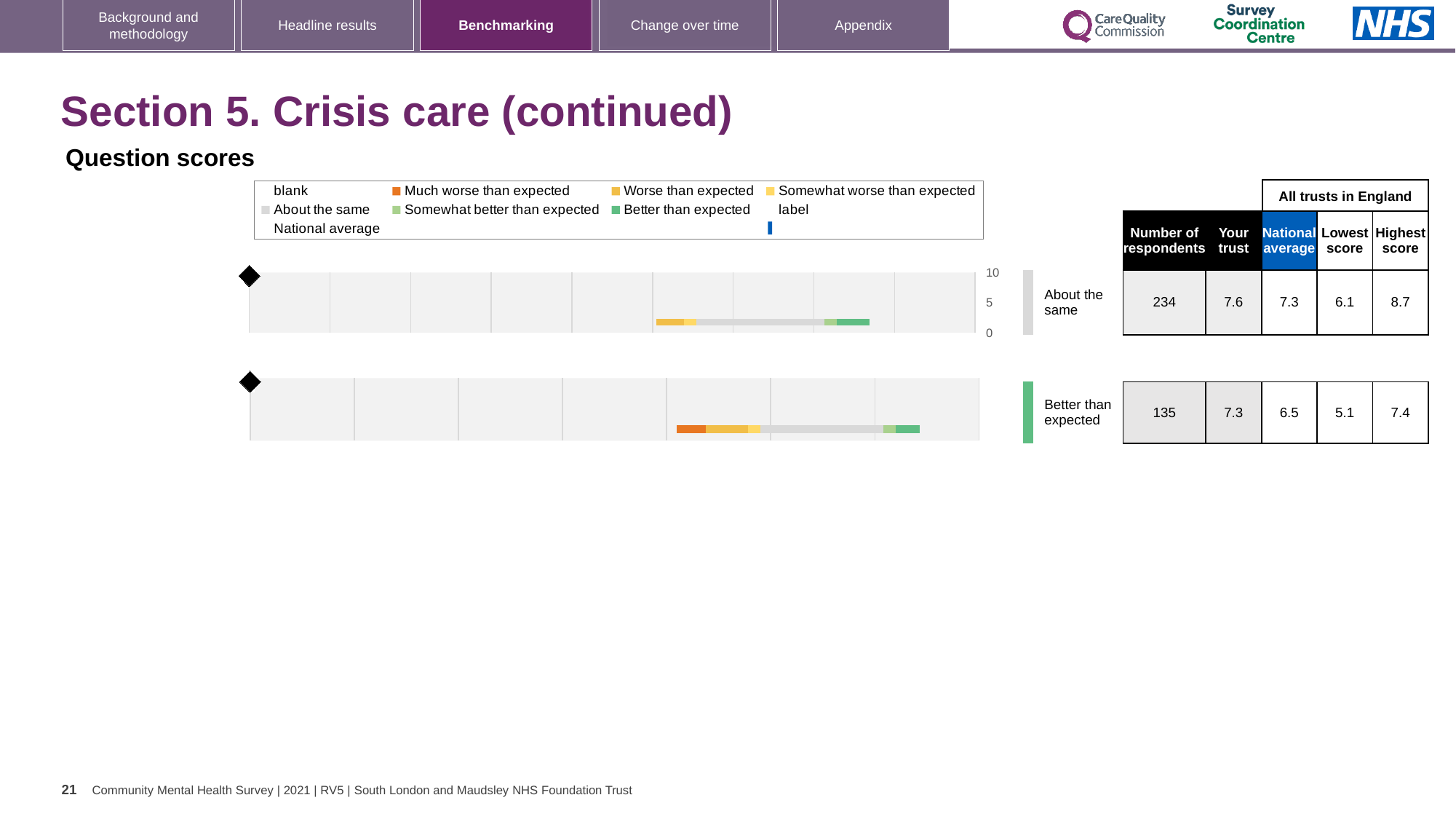
For the second (bottom) chart, what is the difference between the 'Your trust' score and the national average? 0.8 For the first (top) chart, how many respondents are listed in the table? 234 For the first (top) chart, what is the 'Your trust' score? 7.6 How many charts are shown on the slide? 2 What is the maximum value shown on the score axis of the first (top) chart? 10 For the second (bottom) chart, what is the lowest score among all trusts in England? 5.1 For the first (top) chart, what is the difference between the highest and lowest scores among all trusts in England? 2.6 For the second (bottom) chart, what is the highest score among all trusts in England? 7.4 For the first (top) chart, which is larger: the 'Your trust' score or the national average? Your trust For the first (top) chart, what is the national average score? 7.3 Which benchmark category is shown next to the second (bottom) chart? Better than expected What kind of chart is used on this slide to show the question scores? bar chart